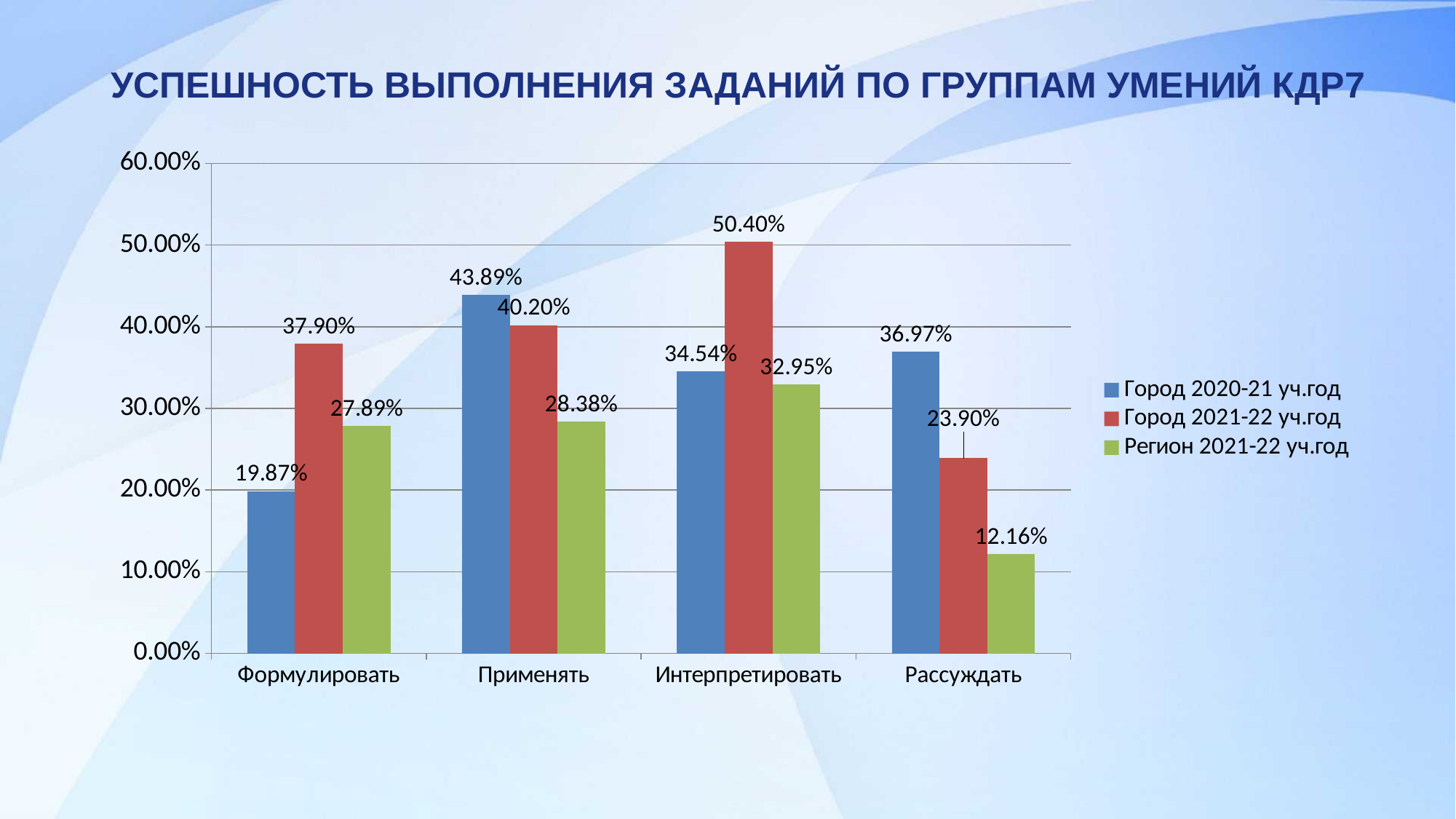
What is the value for Город 2020-21 уч.год in the Формулировать category? 19.87% Is the value for Город 2020-21 уч.год in the Рассуждать category greater or less than 30.00%? greater What is the difference between Город 2021-22 уч.год and Город 2020-21 уч.год in the Формулировать category? 18.03% How many categories are shown on the x axis? 4 What kind of chart is shown on the slide? bar chart What is the value for Город 2021-22 уч.год in the Интерпретировать category? 50.40% What is the value for Регион 2021-22 уч.год in the Рассуждать category? 12.16% In which category does the Город 2021-22 уч.год series reach its highest value? Интерпретировать How many series does the legend list? 3 In the Применять category, which series is larger: Город 2020-21 уч.год or Регион 2021-22 уч.год? Город 2020-21 уч.год In which category does the Регион 2021-22 уч.год series have its lowest value? Рассуждать What is the title of the slide? УСПЕШНОСТЬ ВЫПОЛНЕНИЯ ЗАДАНИЙ ПО ГРУППАМ УМЕНИЙ КДР7